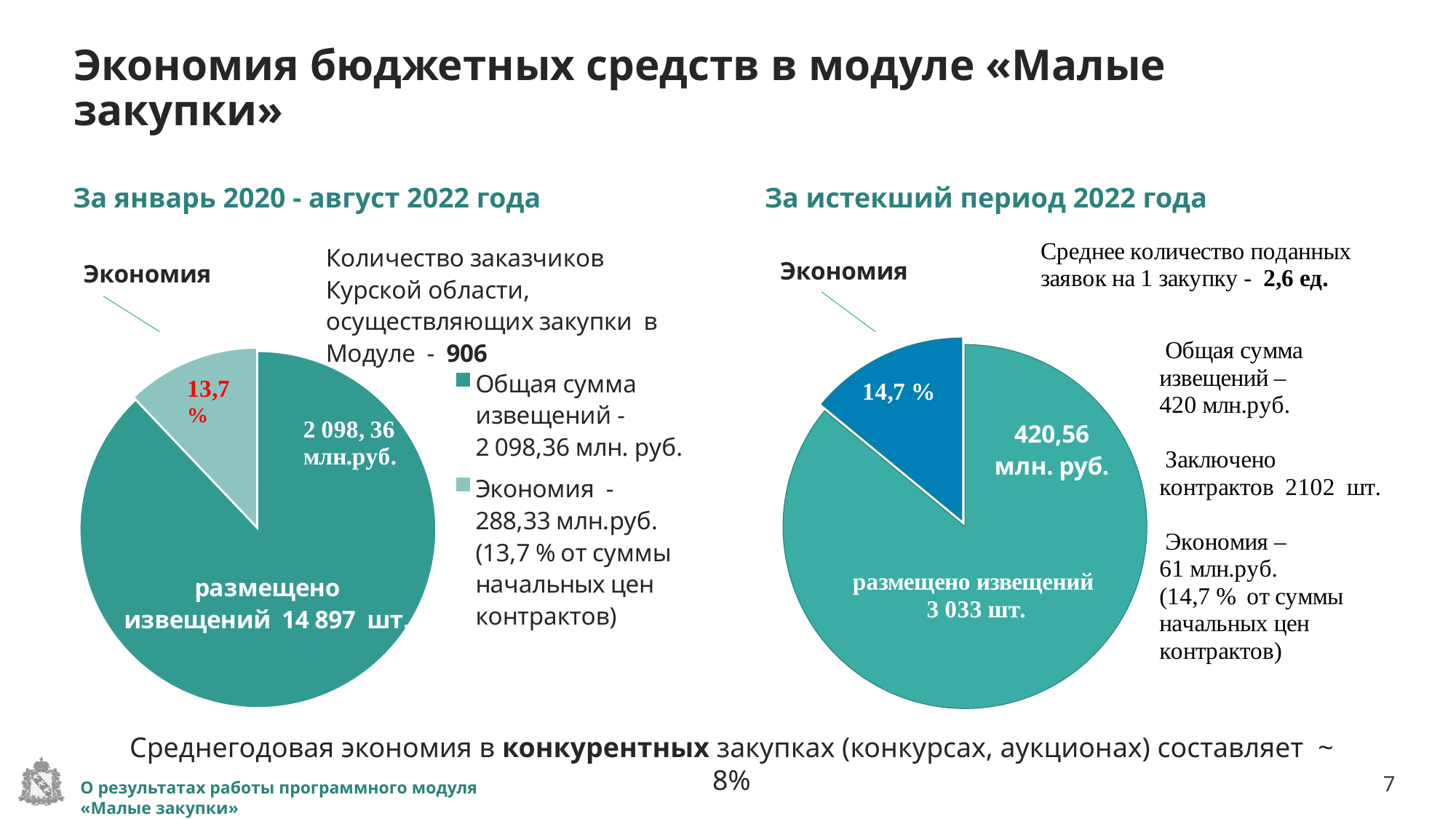
How many slices does the left pie chart (За январь 2020 - август 2022 года) have? 2 In the left pie chart (За январь 2020 - август 2022 года), what value in млн.руб. is printed on the large slice? 2 098, 36 млн.руб. How many entries does the legend of the left pie chart (За январь 2020 - август 2022 года) list? 2 In the left pie chart (За январь 2020 - август 2022 года), which slice is the smallest? Экономия In the right pie chart (За истекший период 2022 года), what value in млн. руб. is printed on the large slice? 420,56 млн. руб. Which pie chart shows a larger Экономия share: the left one (За январь 2020 - август 2022 года) or the right one (За истекший период 2022 года)? the right one (14,7 %) In the right pie chart (За истекший период 2022 года), what percentage is shown for the Экономия slice? 14,7 % What type of chart is used on the left side of the slide (За январь 2020 - август 2022 года)? pie chart In the left pie chart (За январь 2020 - август 2022 года), how many извещений were размещено according to the label on the chart? 14 897 шт. In the right pie chart (За истекший период 2022 года), how many извещений were размещено according to the label on the chart? 3 033 шт. In the left pie chart (За январь 2020 - август 2022 года), what percentage is shown for the Экономия slice? 13,7 % What type of chart is used on the right side of the slide (За истекший период 2022 года)? pie chart